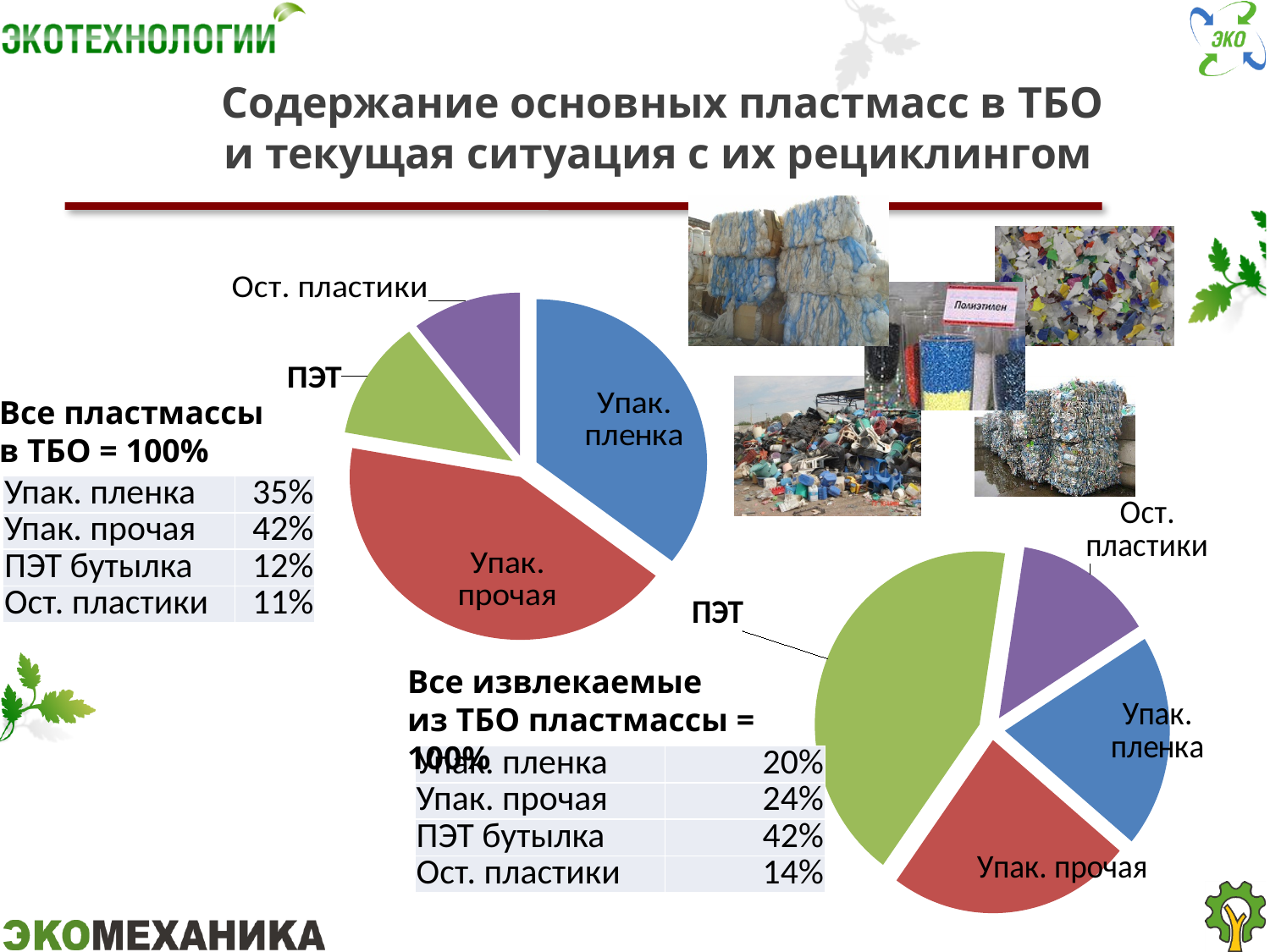
What kind of chart is used on the slide to show the composition of plastics in municipal solid waste? pie chart In the lower-right pie chart (Все извлекаемые из ТБО пластмассы = 100%), what share does ПЭТ бутылка have? 42% In the lower-right pie chart (Все извлекаемые из ТБО пластмассы = 100%), which category has the largest slice? ПЭТ бутылка In the left pie chart (Все пластмассы в ТБО = 100%), what share does Упак. пленка have? 35% In the lower-right pie chart (Все извлекаемые из ТБО пластмассы = 100%), which is larger: Упак. прочая or Упак. пленка? Упак. прочая In the lower-right pie chart (Все извлекаемые из ТБО пластмассы = 100%), what is the difference between the shares of ПЭТ бутылка and Упак. прочая? 18% In the left pie chart (Все пластмассы в ТБО = 100%), what is the difference between the shares of Упак. прочая and Упак. пленка? 7% In the left pie chart (Все пластмассы в ТБО = 100%), what share does ПЭТ бутылка have? 12% In the left pie chart (Все пластмассы в ТБО = 100%), which category has the smallest slice? Ост. пластики In the left pie chart (Все пластмассы в ТБО = 100%), which category has the largest slice? Упак. прочая In the lower-right pie chart (Все извлекаемые из ТБО пластмассы = 100%), what share does Ост. пластики have? 14% How many slices does each pie chart on the slide have? 4